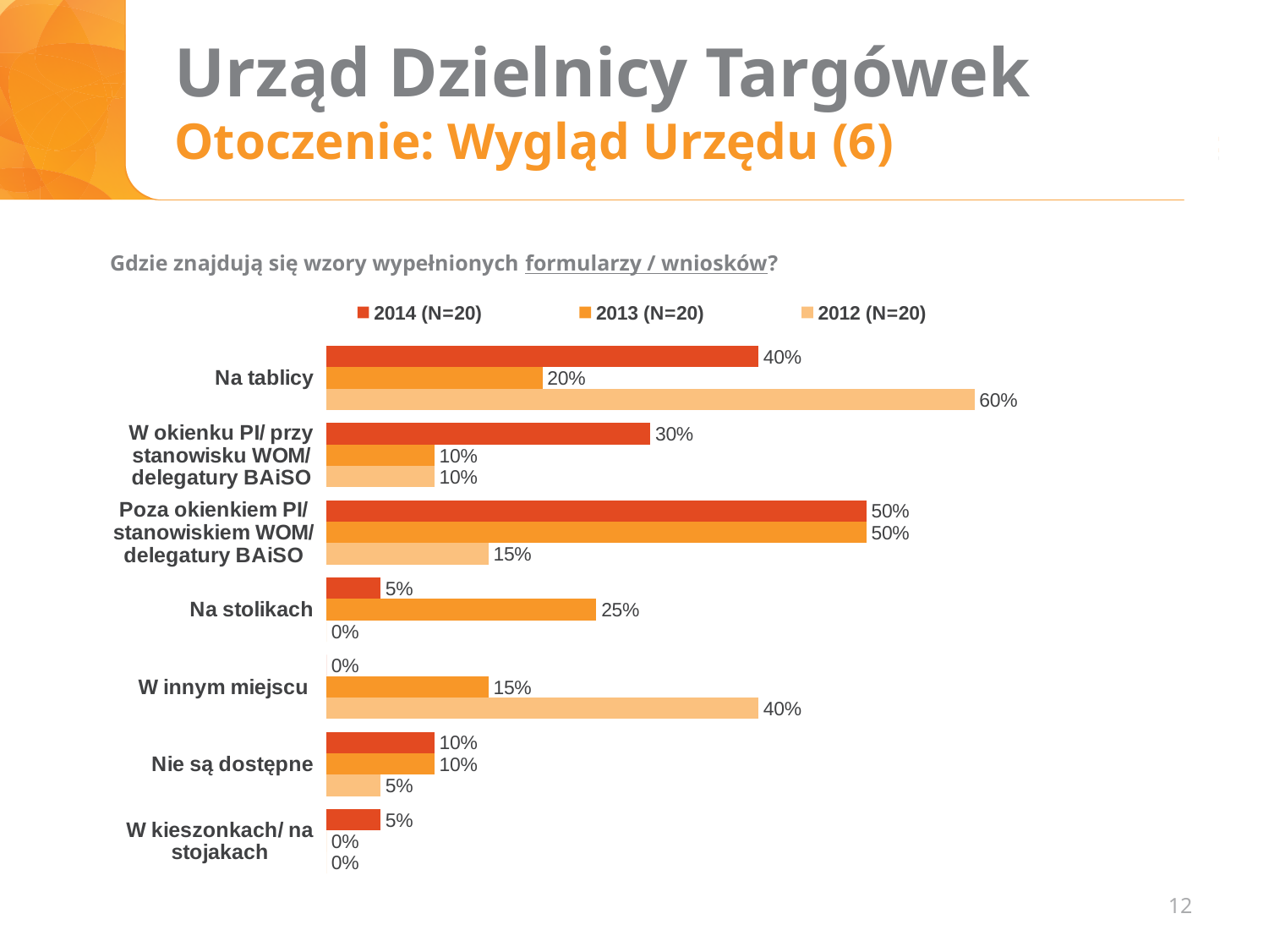
What is the value for "W innym miejscu" in the 2012 (N=20) series? 40% How many series does the legend list? 3 What is the value for "Na stolikach" in the 2013 (N=20) series? 25% What is the value for "Nie są dostępne" in the 2012 (N=20) series? 5% For "W okienku PI/ przy stanowisku WOM/ delegatury BAiSO", which series has the larger value: 2014 (N=20) or 2013 (N=20)? 2014 (N=20) What question does the chart answer, as stated above it? Gdzie znajdują się wzory wypełnionych formularzy / wniosków? How many categories are shown on the chart? 7 What is the value for "Na tablicy" in the 2014 (N=20) series? 40% What kind of chart is shown on the slide? Bar chart Which category has the highest value in the 2014 (N=20) series? Poza okienkiem PI/ stanowiskiem WOM/ delegatury BAiSO Which category has the highest value in the 2012 (N=20) series? Na tablicy What is the difference between the 2012 (N=20) and 2013 (N=20) values for "Na tablicy"? 40%